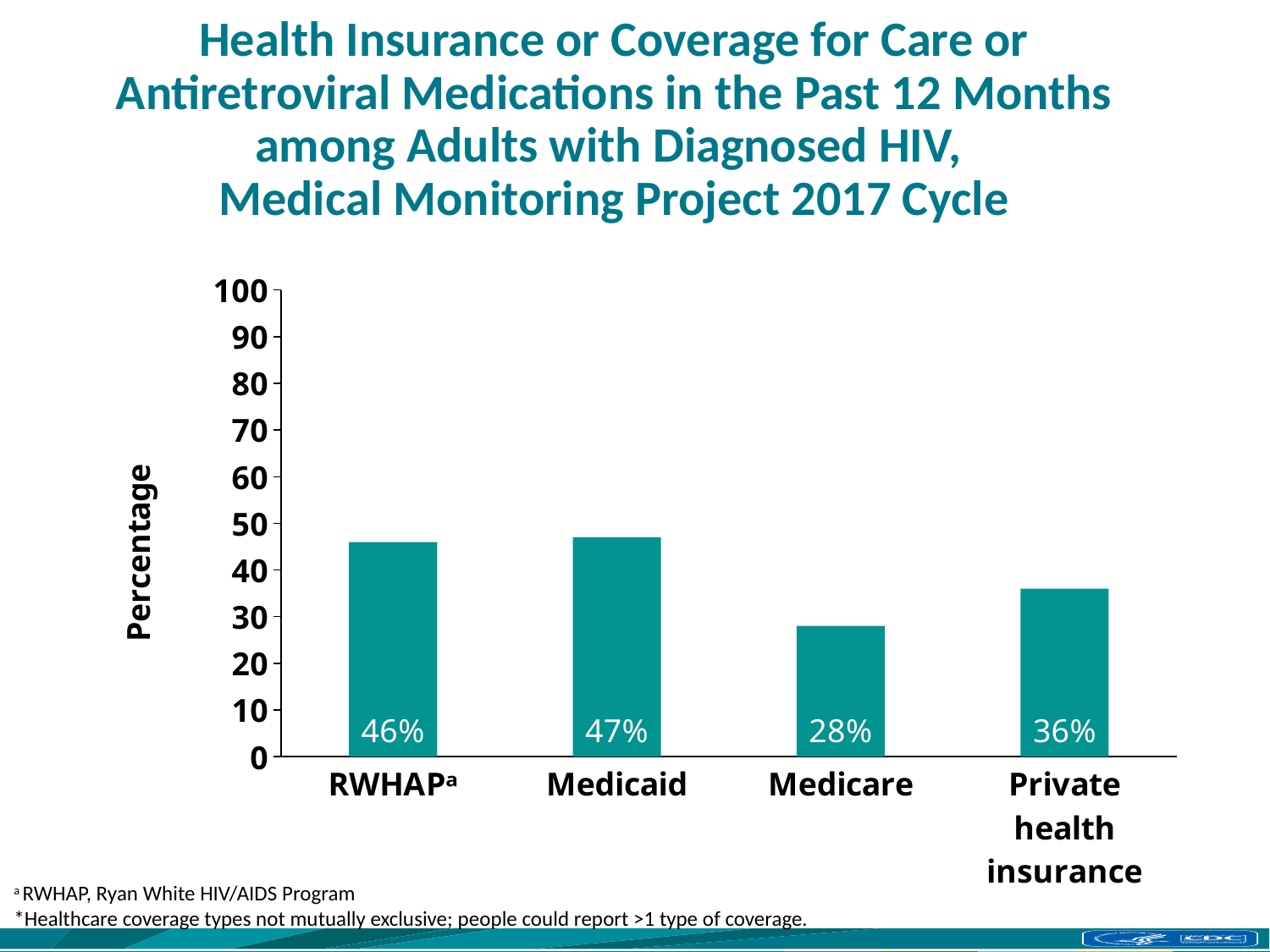
What is the difference in percentage points between Medicaid and Medicare? 19 Which coverage type has the highest percentage? Medicaid Is the value for Private health insurance greater or less than 40? less How many coverage types are shown on the x axis? 4 What is the label of the y axis? Percentage What percentage is shown for RWHAP? 46% Which coverage type has the lowest percentage? Medicare Which is larger, the value for RWHAP or the value for Private health insurance? RWHAP What percentage is shown for Private health insurance? 36% What percentage is shown for Medicaid? 47% What kind of chart is shown on the slide? bar chart What percentage is shown for Medicare? 28%